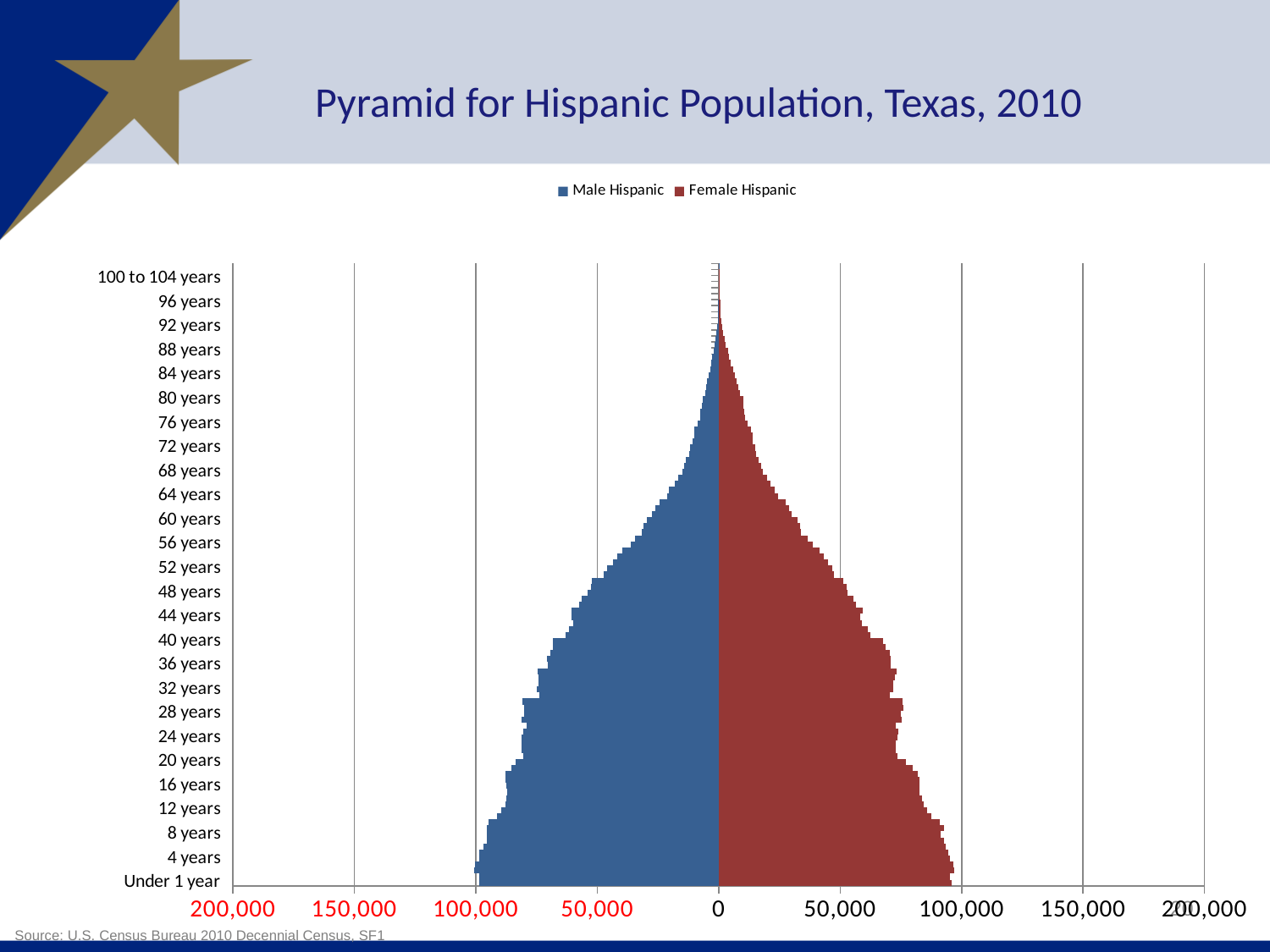
Is the Female Hispanic value for Under 1 year greater or less than 150,000? less What kind of chart is shown on the slide? Bar chart (population pyramid) Is the Female Hispanic value for 72 years greater or less than 50,000? less Which is larger for Male Hispanic: the value for 40 years or the value for 80 years? 40 years What is the title of the chart? Pyramid for Hispanic Population, Texas, 2010 Is the Female Hispanic value for 40 years greater or less than 50,000? greater Which is larger for Female Hispanic: the value for 8 years or the value for 64 years? 8 years Do the Male Hispanic values generally rise or fall as age increases from Under 1 year to 100 to 104 years? fall How many series does the legend list? 2 Which series is shown in blue? Male Hispanic